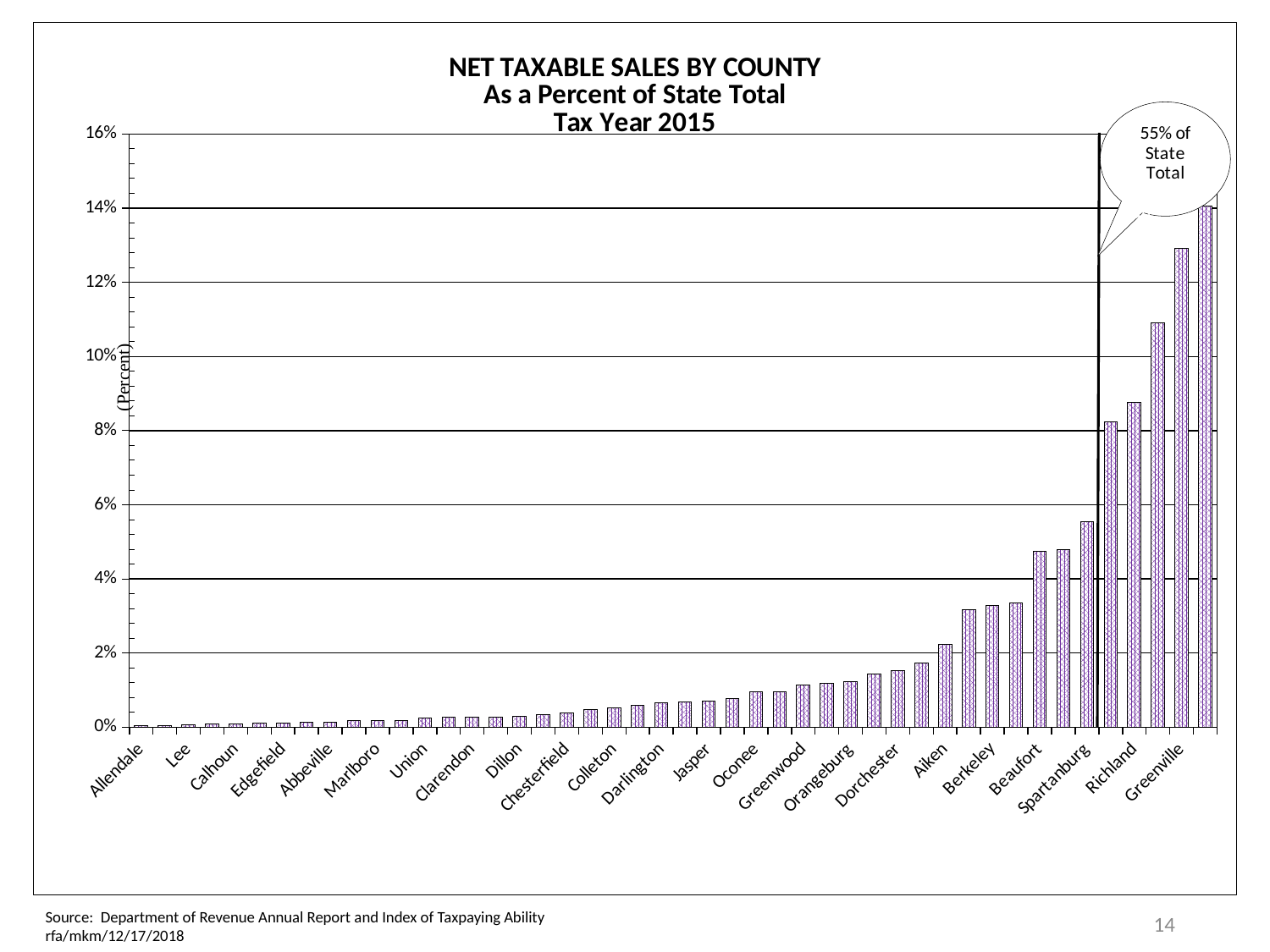
Is the value for Dorchester greater or less than 2%? less Is the value for Allendale greater or less than 2%? less Which county has a larger value, Greenville or Aiken? Greenville What does the callout on the right side of the chart say? 55% of State Total What is the highest value shown on the y axis? 16% What kind of chart is shown on the slide? bar chart Which county has the lowest net taxable sales as a percent of state total? Allendale Do the values rise or fall moving from left to right along the x axis? rise Is the value for Greenville greater or less than 12%? greater What is the title of the chart? NET TAXABLE SALES BY COUNTY As a Percent of State Total Tax Year 2015